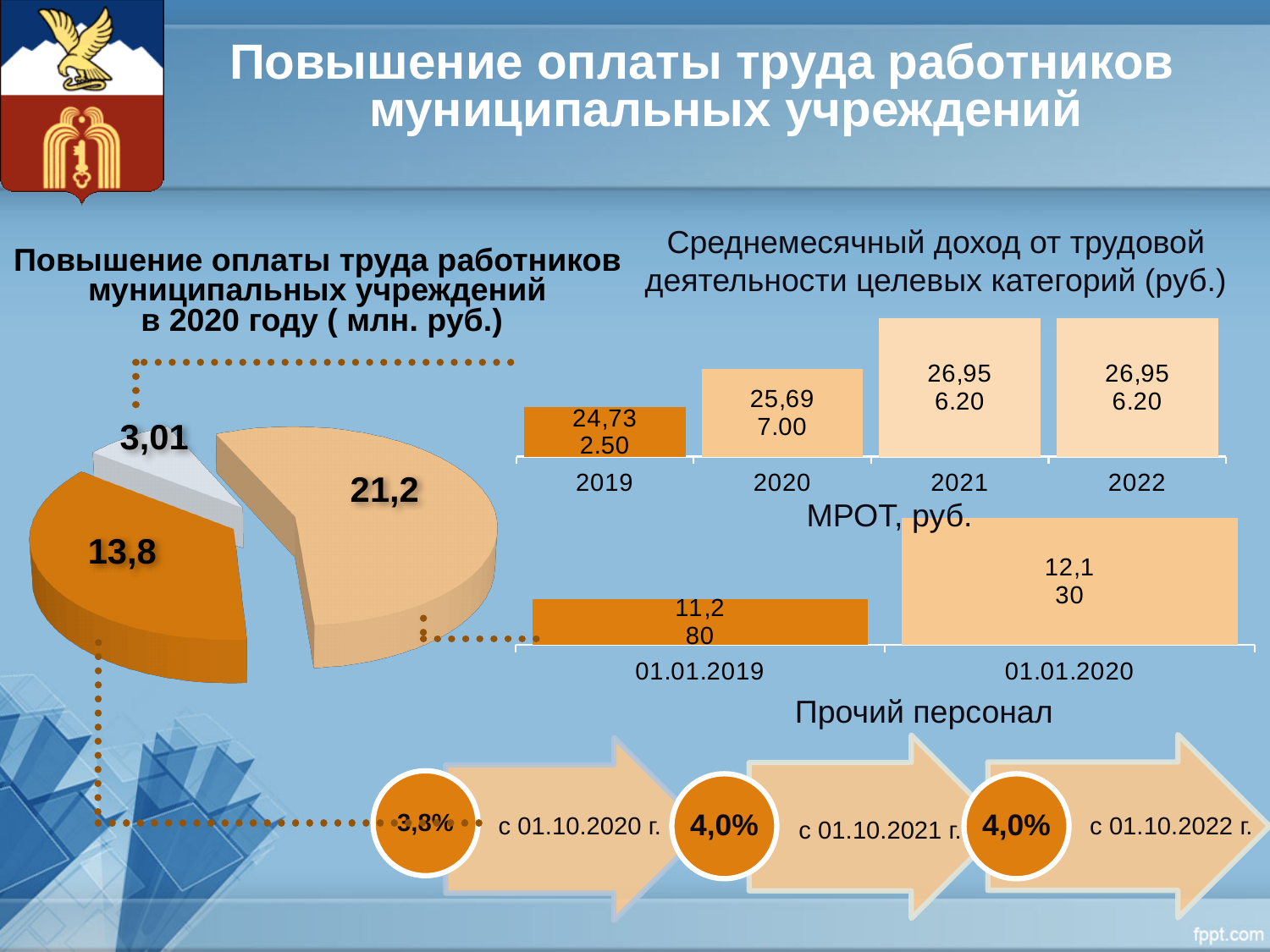
In the chart 'МРОТ, руб.', what is the difference between the value for 01.01.2020 and the value for 01.01.2019? 850 In the chart 'МРОТ, руб.', what is the value for 01.01.2020? 12,130 How many years are shown in the chart 'Среднемесячный доход от трудовой деятельности целевых категорий (руб.)'? 4 How many slices does the pie chart on the left have? 3 In the chart 'Среднемесячный доход от трудовой деятельности целевых категорий (руб.)', what is the value for 2019? 24,732.50 What kind of chart is the chart on the left titled 'Повышение оплаты труда работников муниципальных учреждений в 2020 году ( млн. руб.)'? pie chart In the pie chart on the left, what is the total of all three slices? 38,01 In the pie chart on the left, what is the value of the largest slice? 21,2 In the pie chart on the left, what is the value of the smallest slice? 3,01 What kind of chart is the chart titled 'МРОТ, руб.'? bar chart In the chart 'Среднемесячный доход от трудовой деятельности целевых категорий (руб.)', what is the value for 2021? 26,956.20 In the chart 'Среднемесячный доход от трудовой деятельности целевых категорий (руб.)', which is larger, the value for 2019 or the value for 2020? 2020